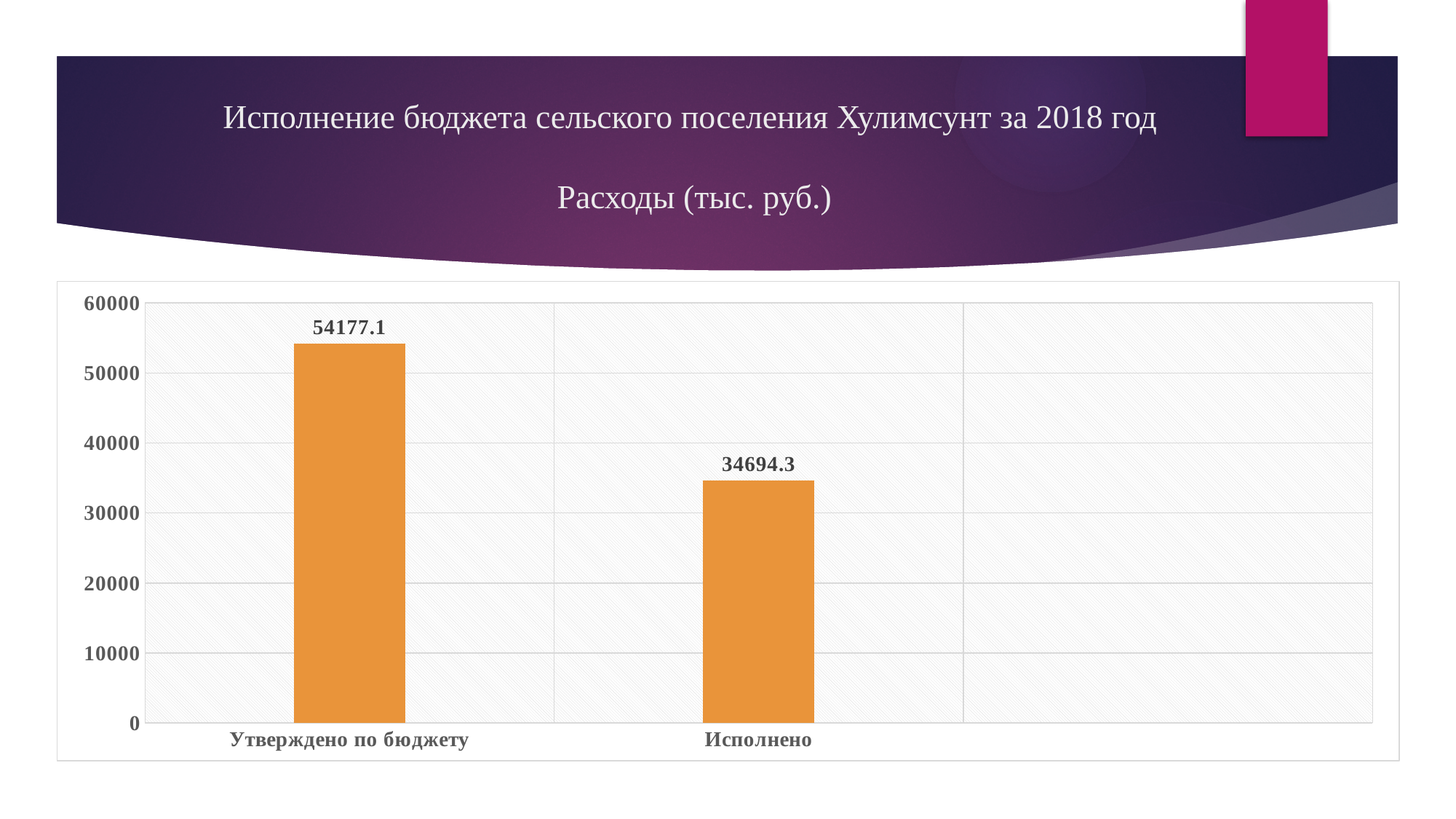
Which category has the highest value? Утверждено по бюджету Is the value for Утверждено по бюджету greater or less than 50000? greater What kind of chart is shown on the slide? bar chart What is the value for Исполнено? 34694.3 How many categories are shown on the x axis? 2 What is the highest value shown on the vertical axis? 60000 What is the value for Утверждено по бюджету? 54177.1 Is the value for Исполнено greater or less than 40000? less Which is larger, the value for Утверждено по бюджету or the value for Исполнено? Утверждено по бюджету Which category has the lowest value? Исполнено Do the values rise or fall from left to right along the x axis? fall What is the difference between the values for Утверждено по бюджету and Исполнено? 19482.8